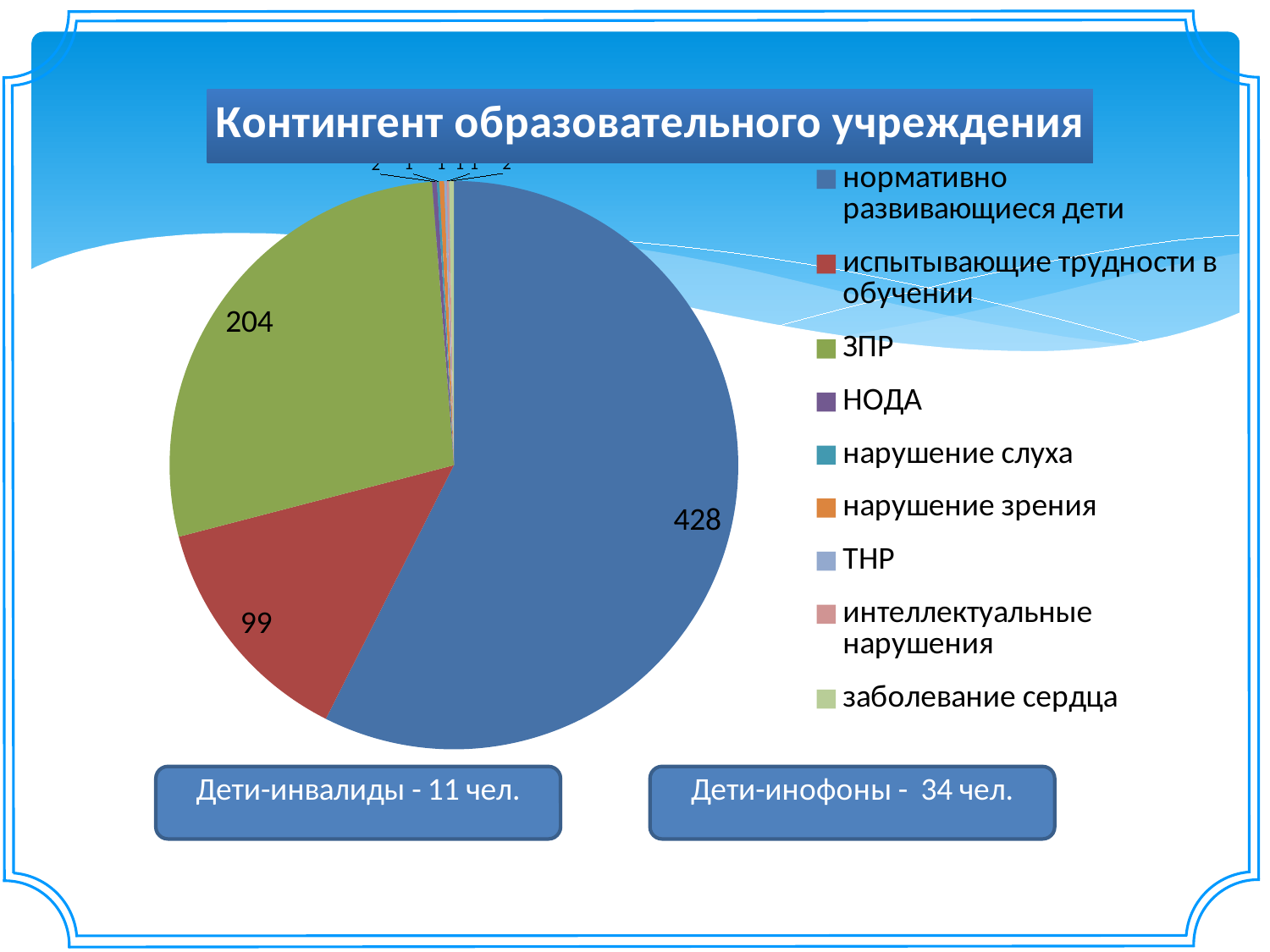
What is the title of the chart? Контингент образовательного учреждения What is the value for нормативно развивающиеся дети? 428 What is the value for ЗПР? 204 What is the difference between the values for ЗПР and испытывающие трудности в обучении? 105 Which is larger: ЗПР or испытывающие трудности в обучении? ЗПР How many categories does the legend of the pie chart list? 9 What is the difference between the values for нормативно развивающиеся дети and ЗПР? 224 Which category has the largest slice of the pie? нормативно развивающиеся дети What colour is the slice for ЗПР? green What is the value for испытывающие трудности в обучении? 99 What kind of chart is shown on the slide? pie chart